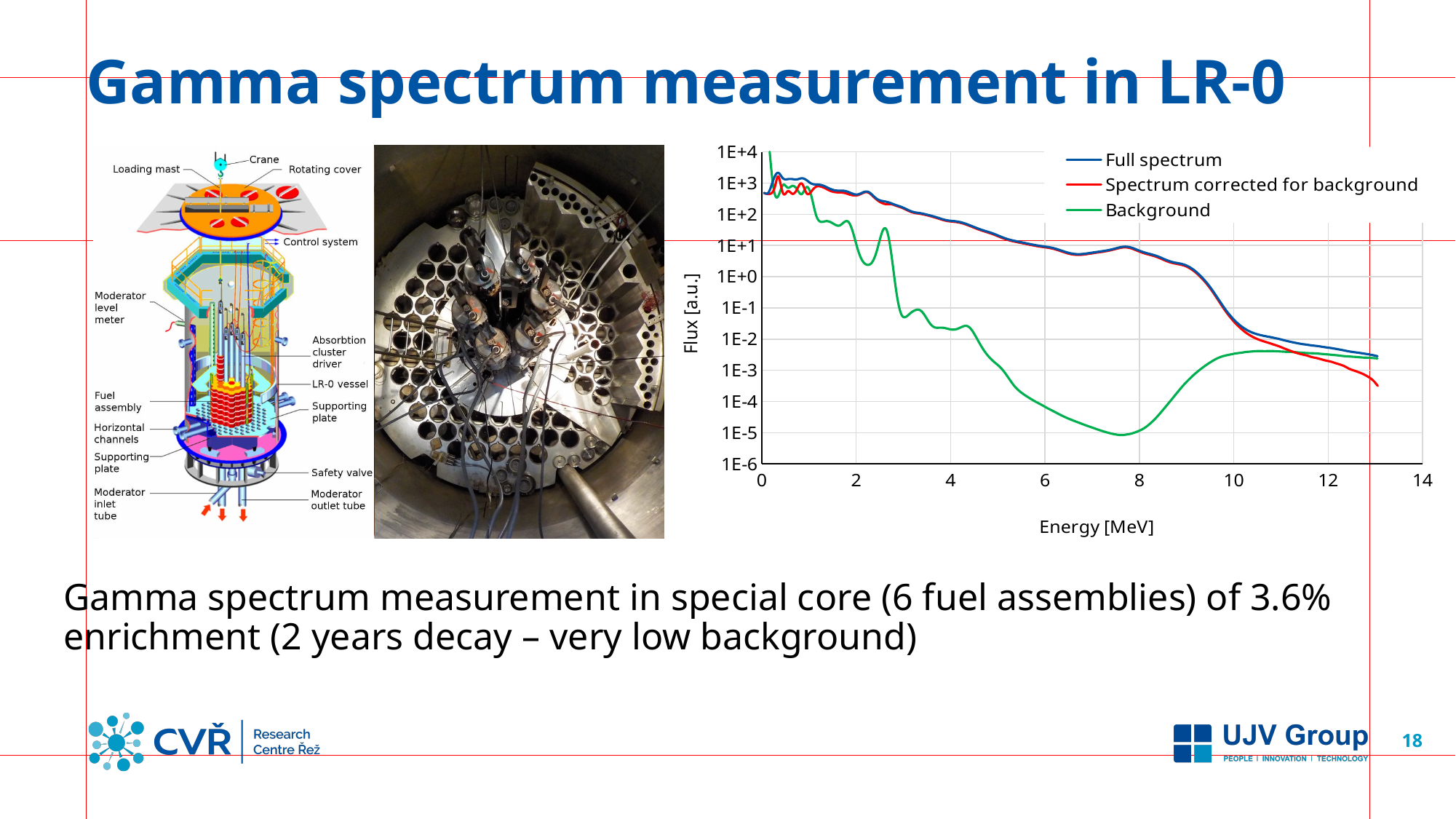
What kind of chart is shown on the slide? Line chart At 6 MeV, which is larger: the Full spectrum or the Background? Full spectrum Which series has the lowest value at 8 MeV? Background At 12 MeV, which is larger: the Full spectrum or the Spectrum corrected for background? Full spectrum How many series does the legend of the chart list? 3 Is the Full spectrum value at 2 MeV greater or less than 1E+1? greater Is the Full spectrum value at 10 MeV greater or less than 1E+0? less Is the Background value at 12 MeV greater or less than 1E-2? less Does the Full spectrum series generally rise or fall as energy increases along the x axis? Fall What colour is the Background series drawn in on the chart? Green What is the label of the vertical axis of the chart? Flux [a.u.]